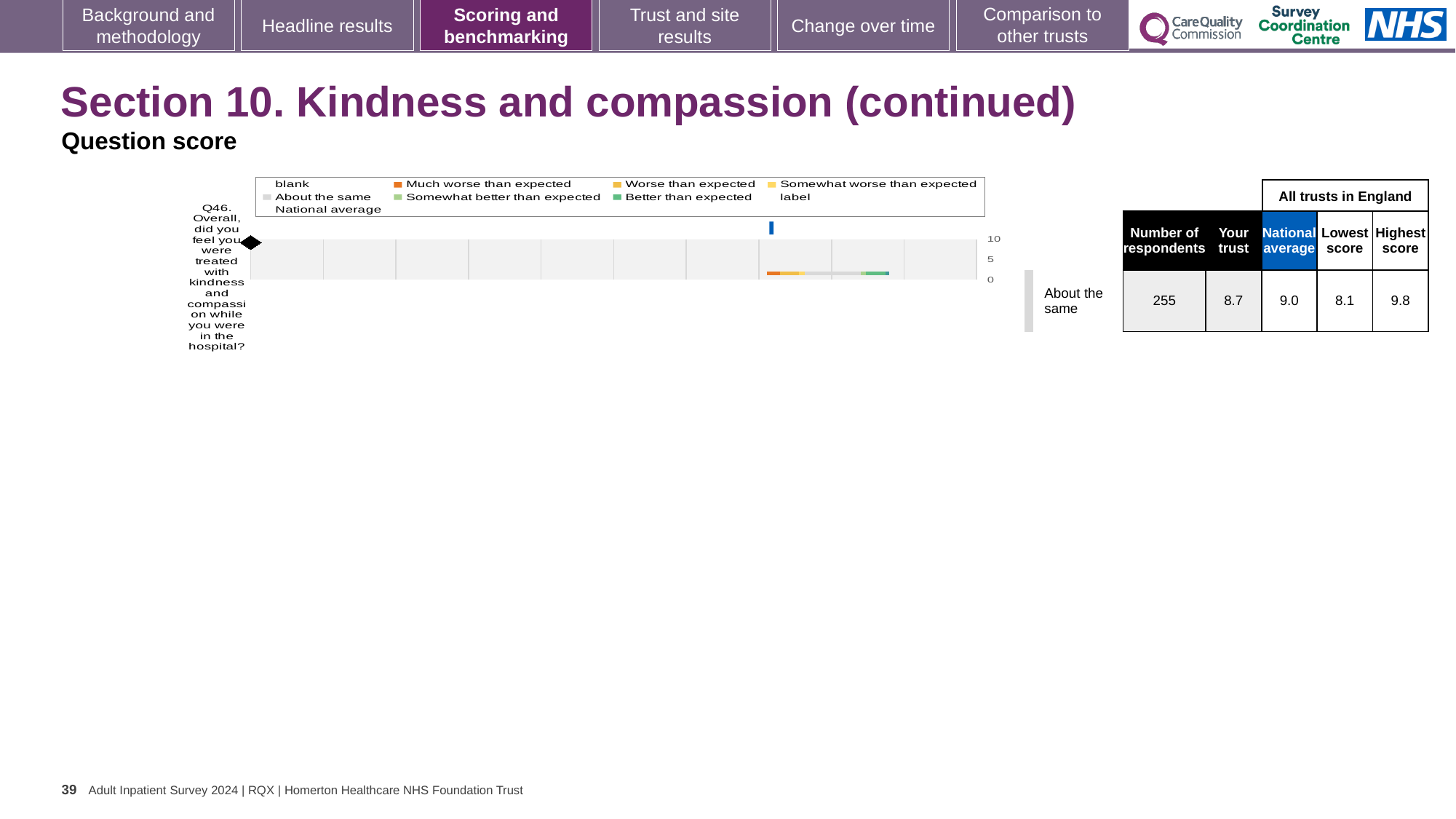
What is the highest tick value shown on the chart's numeric axis? 10 What benchmark category is given for the trust's Q46 score? About the same According to the table beside the chart, what is the Lowest score among all trusts in England for Q46? 8.1 How many questions (categories) are plotted in the chart? 1 What kind of chart is shown on the slide for Q46? bar chart According to the table beside the chart, what is the 'Your trust' score for Q46? 8.7 According to the table beside the chart, what is the National average score for Q46? 9.0 How many respondents are listed for Q46 in the table beside the chart? 255 What is the difference between the Highest score and the Lowest score for Q46 in the table? 1.7 According to the table beside the chart, what is the Highest score among all trusts in England for Q46? 9.8 Which is larger for Q46: the 'Your trust' score or the National average? National average